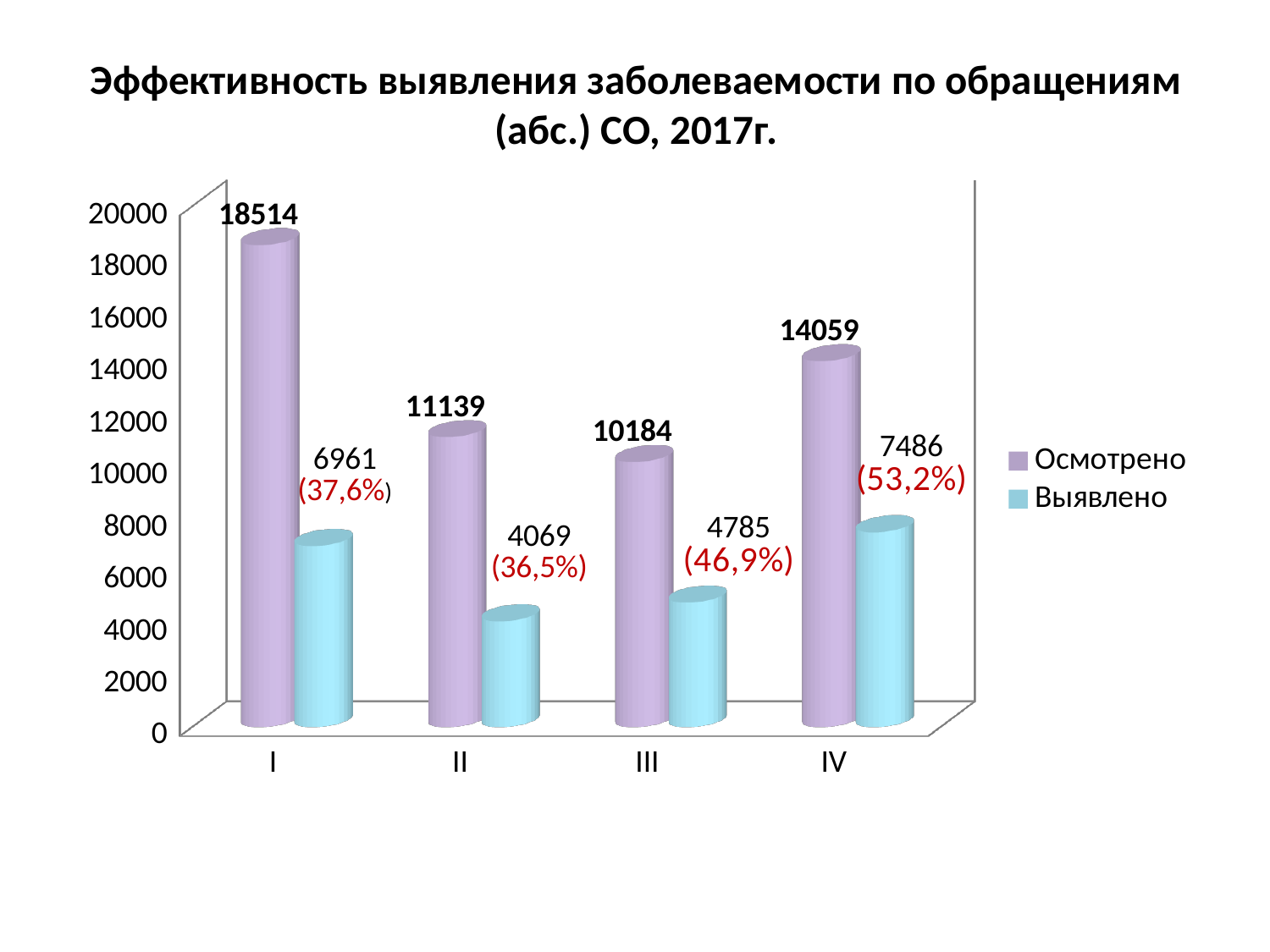
What is the value of Выявлено for category IV? 7486 What kind of chart is shown on the slide? Bar chart How many categories are shown on the x axis? 4 What is the value of Выявлено for category II? 4069 Which is larger: Осмотрено for category II or Осмотрено for category IV? Осмотрено for category IV Which category has the highest Осмотрено value? I What percentage is shown in red next to the Выявлено bar for category IV? 53,2% Which category has the lowest Выявлено value? II What is the value of Осмотрено for category I? 18514 What is the difference between Осмотрено and Выявлено for category III? 5399 How many series does the legend list? 2 What colour are the Выявлено bars? Light blue